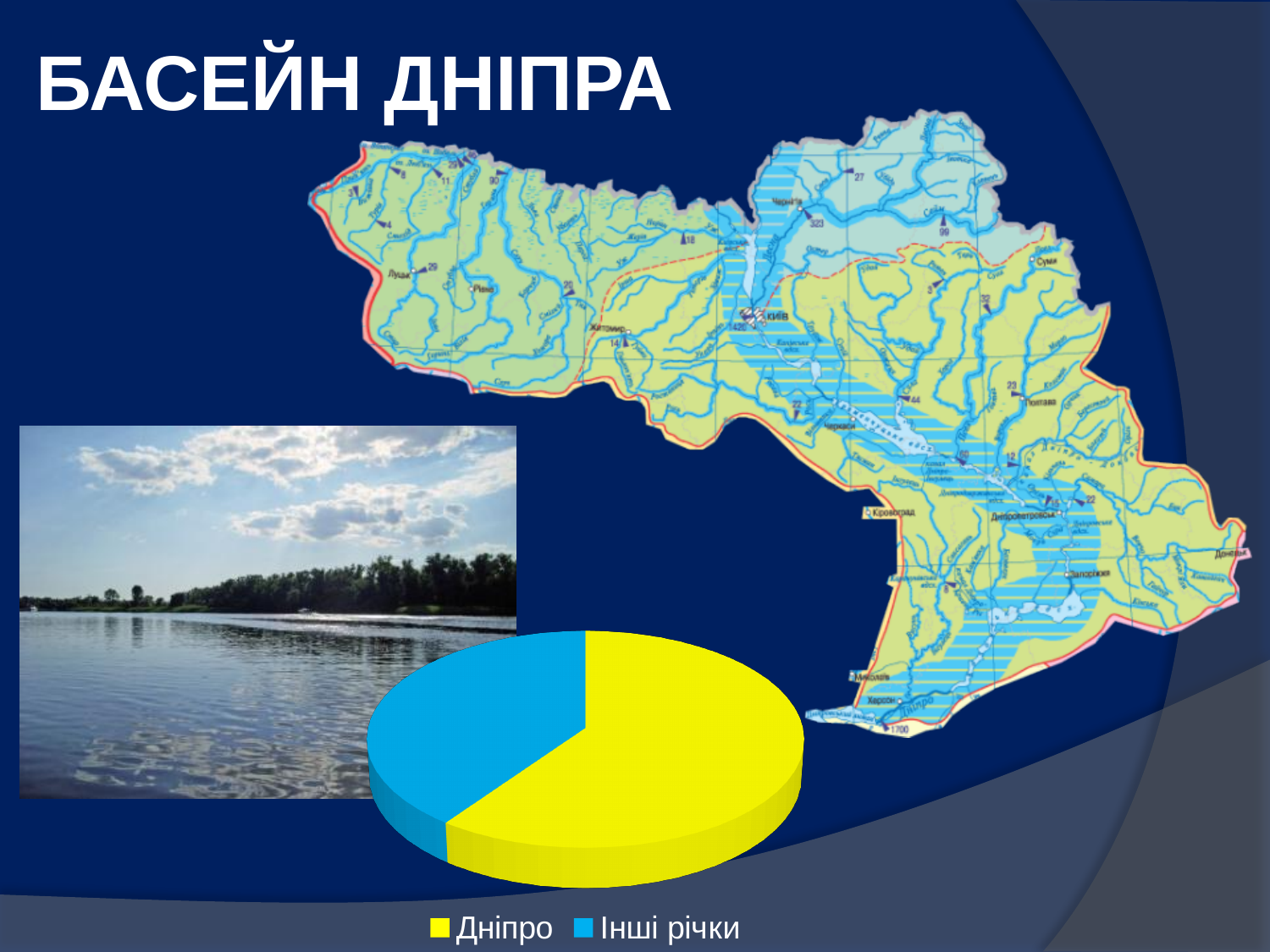
What colour is the Інші річки slice in the pie chart? blue Which slice of the pie chart is the largest? Дніпро How many entries does the legend of the pie chart list? 2 What kind of chart is shown at the bottom of the slide? pie chart How many slices does the pie chart have? 2 Which slice of the pie chart is the smallest? Інші річки What colour is the Дніпро slice in the pie chart? yellow In the pie chart, which is larger: Дніпро or Інші річки? Дніпро